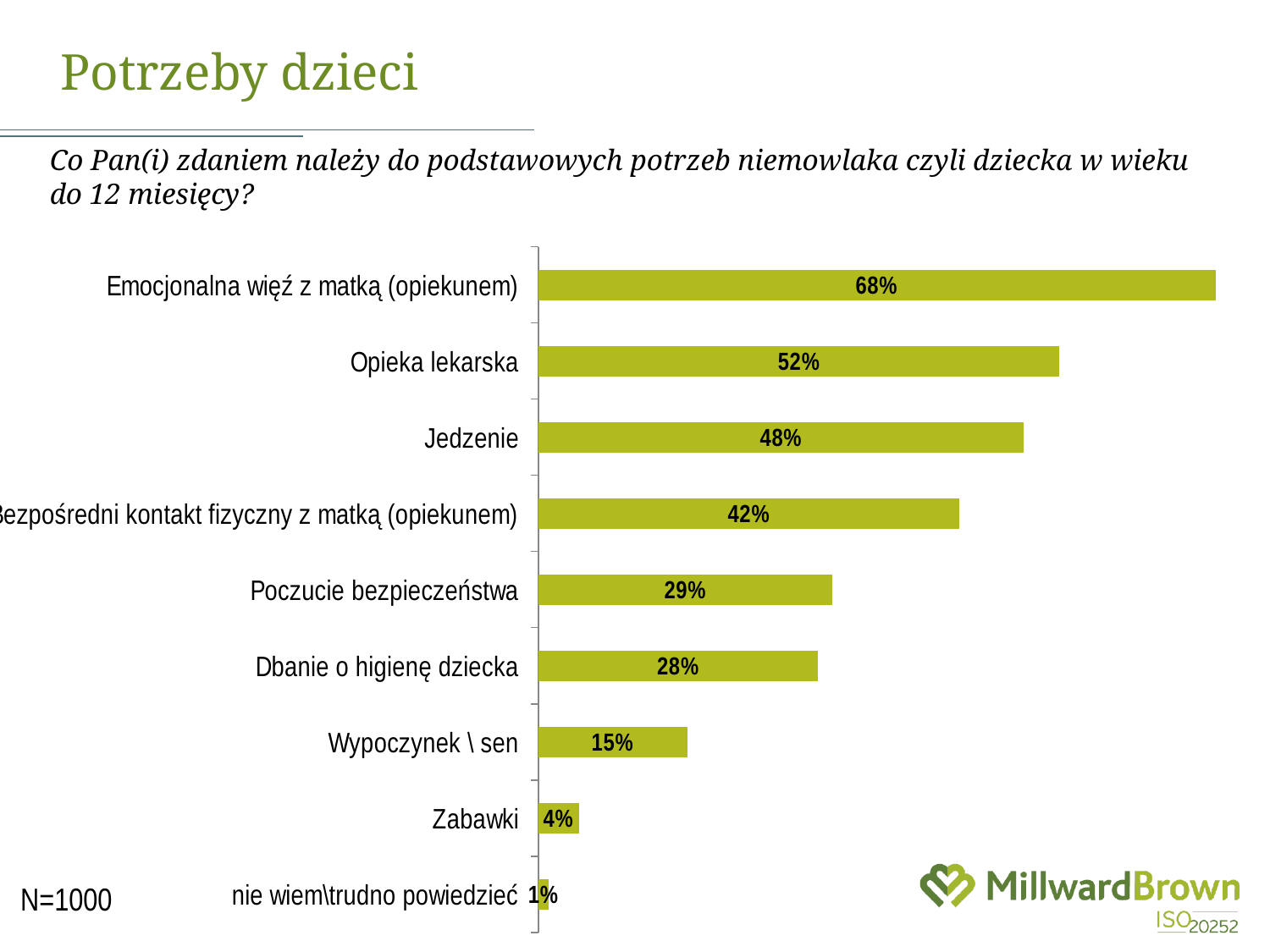
What kind of chart is shown on the slide? Bar chart What is the difference between the values for Emocjonalna więź z matką (opiekunem) and Opieka lekarska? 16% Which is larger, the value for Poczucie bezpieczeństwa or the value for Dbanie o higienę dziecka? Poczucie bezpieczeństwa What is the value for Wypoczynek \ sen? 15% What sample size (N) is stated on the slide? N=1000 What is the value for Zabawki? 4% How many categories are shown in the chart? 9 Which category has the highest value? Emocjonalna więź z matką (opiekunem) What is the value for Opieka lekarska? 52% What is the difference between the values for Jedzenie and Poczucie bezpieczeństwa? 19% What is the value for Jedzenie? 48% Which category has the lowest value? nie wiem\trudno powiedzieć